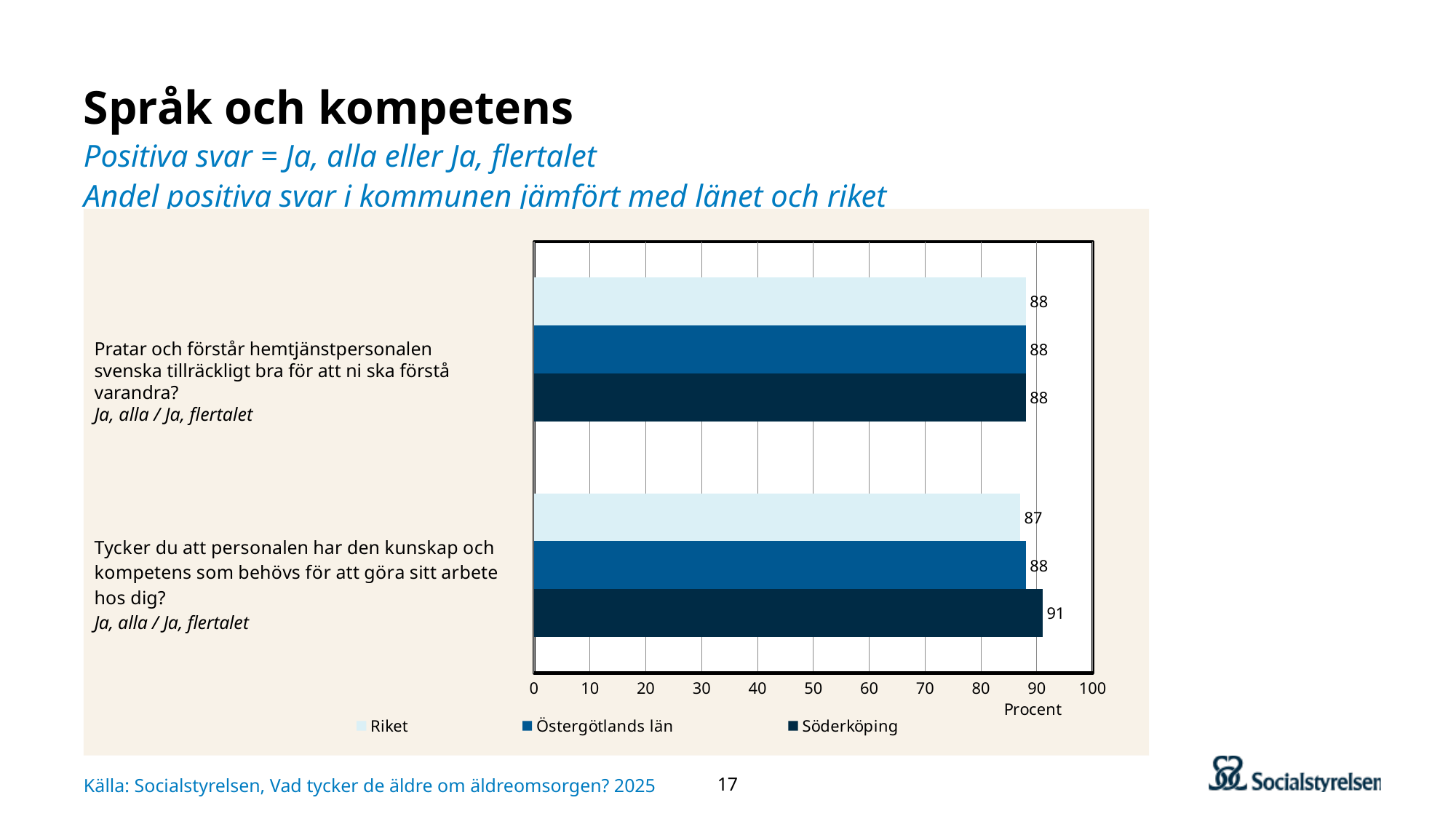
What unit is shown on the x axis of the chart? Procent What kind of chart is shown on the slide? bar chart How many question categories are plotted on the chart? 2 Which legend entry is shown with the darkest bar colour? Söderköping Which series has the highest value on the question "Tycker du att personalen har den kunskap och kompetens som behövs för att göra sitt arbete hos dig?"? Söderköping How many series does the legend list? 3 What is the difference between Söderköping and Riket on the question "Tycker du att personalen har den kunskap och kompetens som behövs för att göra sitt arbete hos dig?"? 4 Which series has the lowest value on the question "Tycker du att personalen har den kunskap och kompetens som behövs för att göra sitt arbete hos dig?"? Riket What is the value for Östergötlands län on the question "Pratar och förstår hemtjänstpersonalen svenska tillräckligt bra för att ni ska förstå varandra?"? 88 What is the value for Riket on the question "Tycker du att personalen har den kunskap och kompetens som behövs för att göra sitt arbete hos dig?"? 87 Is the value for Söderköping on the question "Tycker du att personalen har den kunskap och kompetens som behövs för att göra sitt arbete hos dig?" greater or less than 90? greater What is the value for Söderköping on the question "Tycker du att personalen har den kunskap och kompetens som behövs för att göra sitt arbete hos dig?"? 91